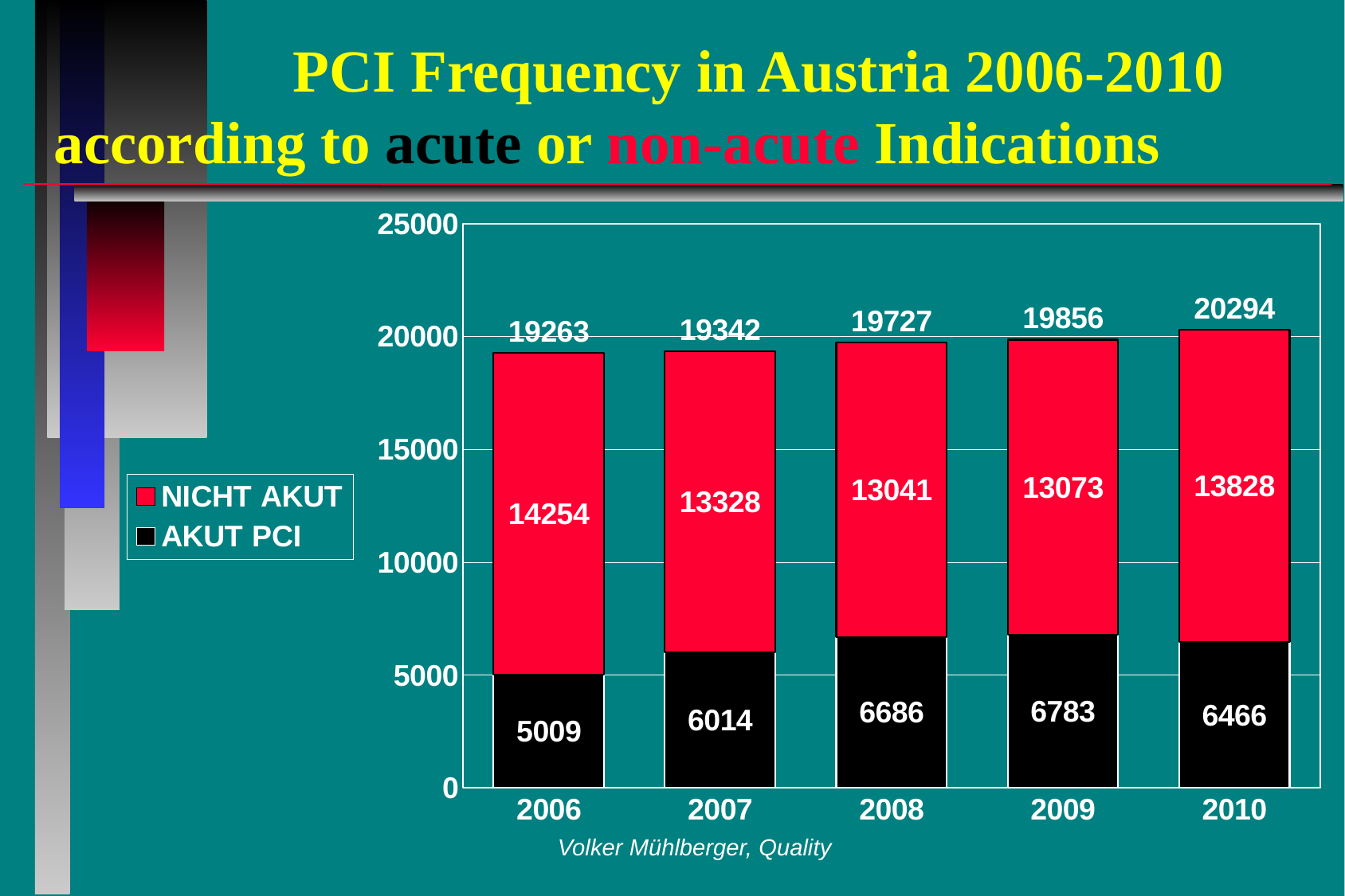
What is the difference between the NICHT AKUT values for 2006 and 2007? 926 Which colour represents NICHT AKUT in the legend? red What is the NICHT AKUT value for 2010? 13828 Which year has the lowest AKUT PCI value? 2006 What kind of chart is shown on the slide? stacked bar chart Which is larger, the AKUT PCI value for 2009 or for 2010? 2009 How many series does the legend list? 2 Which year has the highest total PCI count? 2010 What is the total PCI count shown above the bar for 2008? 19727 What is the AKUT PCI value for 2006? 5009 Is the AKUT PCI value for 2008 greater or less than 5000? greater How many years are shown on the x axis? 5